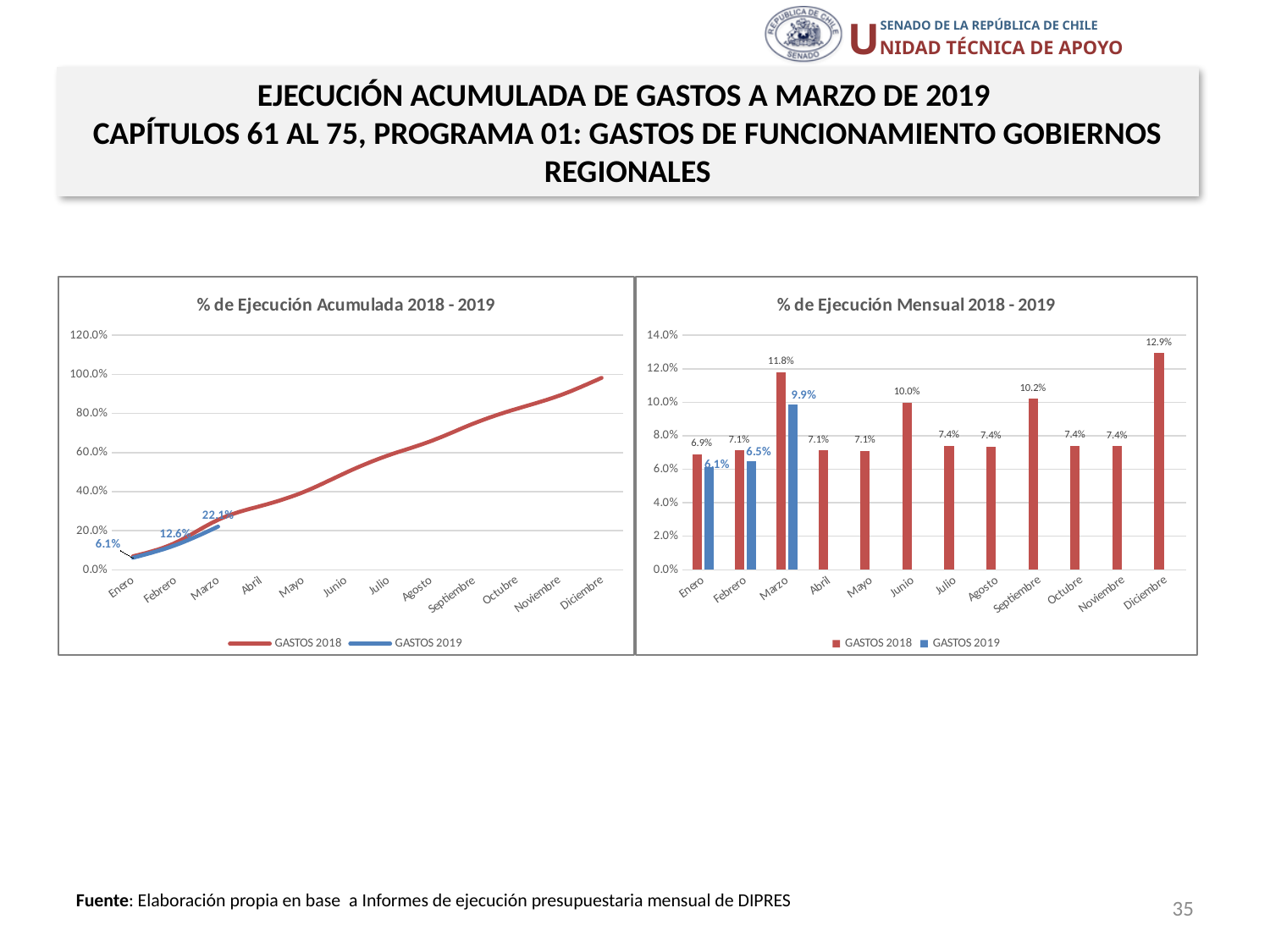
In the chart titled '% de Ejecución Mensual 2018 - 2019', what is the difference between GASTOS 2018 and GASTOS 2019 in Marzo? 1.9% In the chart titled '% de Ejecución Mensual 2018 - 2019', what is the value for GASTOS 2019 in Marzo? 9.9% In the chart titled '% de Ejecución Acumulada 2018 - 2019', what is the value for GASTOS 2019 in Marzo? 22.1% In the chart titled '% de Ejecución Mensual 2018 - 2019', which month has the lowest value for GASTOS 2018? Enero In the chart titled '% de Ejecución Mensual 2018 - 2019', what is the value for GASTOS 2018 in Diciembre? 12.9% What kind of chart is the chart titled '% de Ejecución Mensual 2018 - 2019'? Bar chart In the chart titled '% de Ejecución Mensual 2018 - 2019', which month has the highest value for GASTOS 2018? Diciembre In the chart titled '% de Ejecución Acumulada 2018 - 2019', does the GASTOS 2018 line rise or fall from Enero to Diciembre? Rise In the chart titled '% de Ejecución Acumulada 2018 - 2019', what is the value for GASTOS 2019 in Febrero? 12.6% In the chart titled '% de Ejecución Mensual 2018 - 2019', how many series does the legend list? 2 In the chart titled '% de Ejecución Acumulada 2018 - 2019', is the value for GASTOS 2018 in Diciembre greater or less than 80.0%? greater In the chart titled '% de Ejecución Mensual 2018 - 2019', which is larger in Febrero: GASTOS 2018 or GASTOS 2019? GASTOS 2018